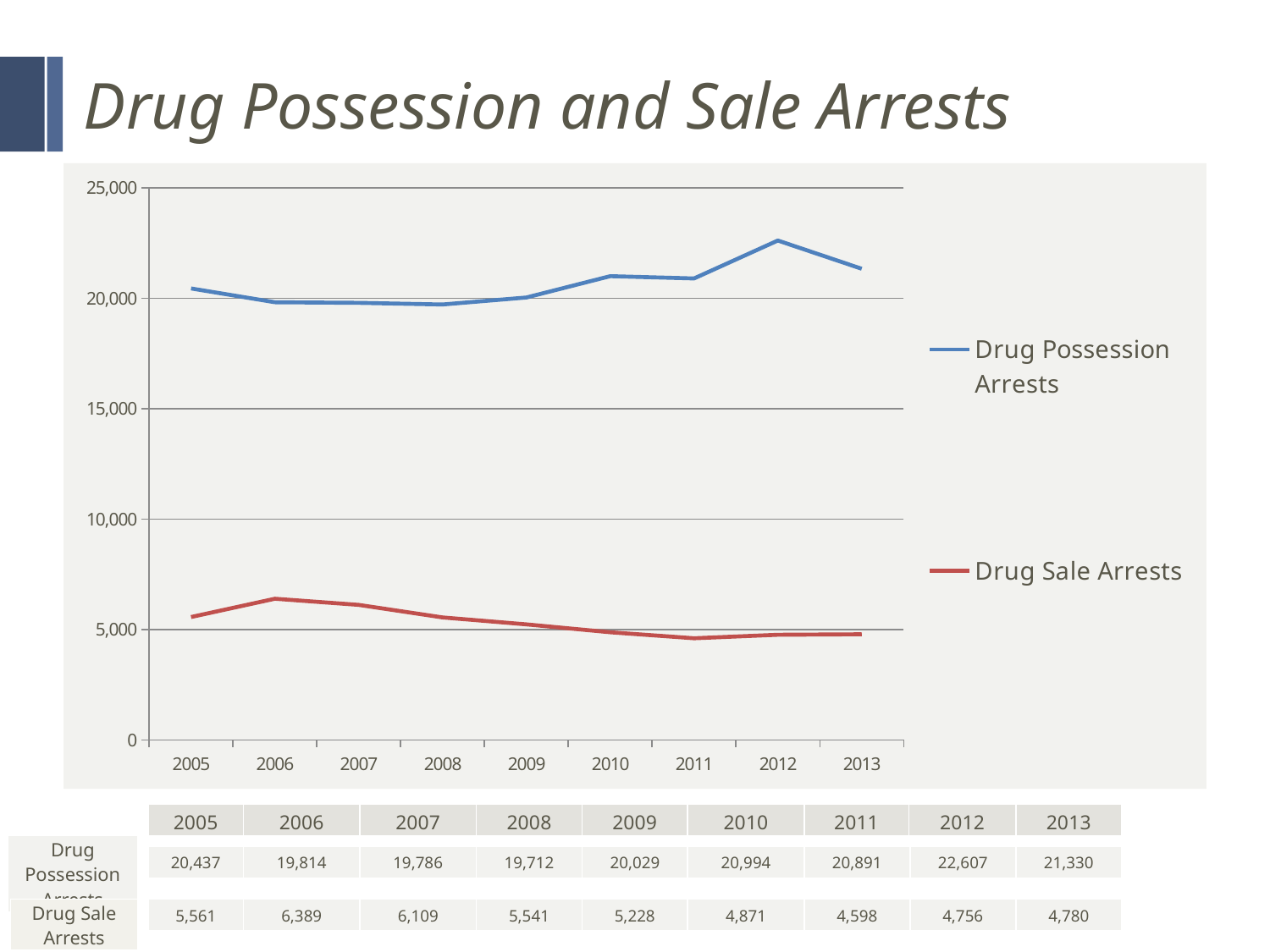
What kind of chart is shown on the slide? Line chart Is the value for Drug Possession Arrests in 2012 greater or less than 20,000? greater How many years are plotted on the x axis? 9 What is the value for Drug Sale Arrests in 2009? 5,228 In which year were Drug Sale Arrests highest? 2006 In which year were Drug Possession Arrests highest? 2012 In which year were Drug Sale Arrests lowest? 2011 How many series does the legend list? 2 What is the value for Drug Possession Arrests in 2012? 22,607 Which is larger: Drug Possession Arrests in 2010 or in 2008? 2010 What is the difference between Drug Sale Arrests in 2006 and 2005? 828 What is the difference between Drug Possession Arrests in 2012 and 2013? 1,277